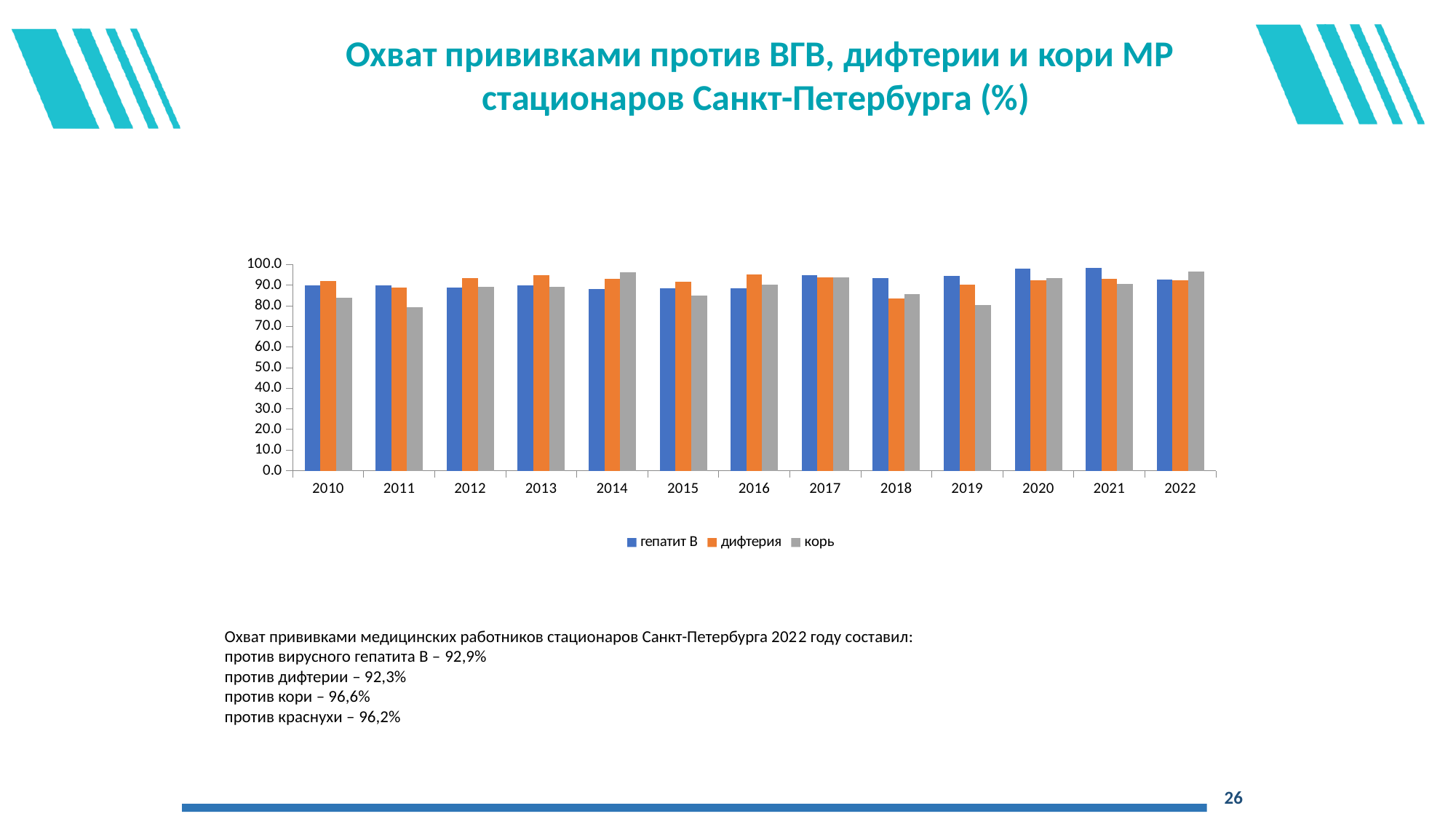
By how many percentage points does the 2022 coverage against корь exceed the 2022 coverage against гепатит B? 3,7 What kind of chart is shown on the slide? bar chart Which series is shown in orange in the legend? дифтерия According to the slide, what was the vaccination coverage against гепатит B in 2022? 92,9% How many series does the legend list? 3 According to the slide, what was the vaccination coverage against корь in 2022? 96,6% How many years are shown on the x axis? 13 In 2014, which is larger: the value for корь or the value for гепатит B? корь According to the slide, what was the vaccination coverage against дифтерия in 2022? 92,3% In which year is the корь value the lowest? 2011 Is the value for дифтерия in 2018 greater or less than 90? less